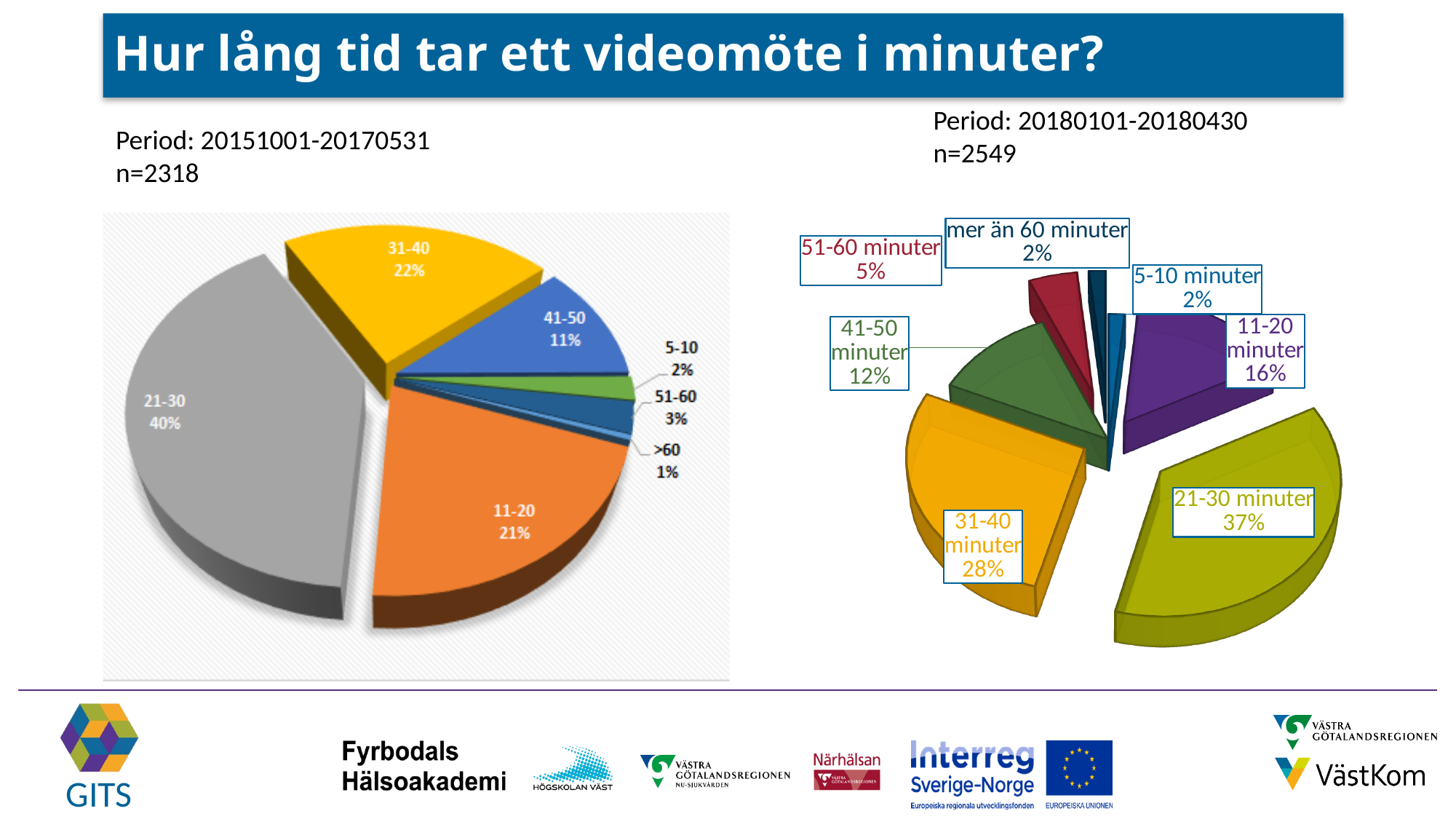
In the right pie chart (period 20180101-20180430), what share do meetings of 41-50 minuter have? 12% In the right pie chart (period 20180101-20180430), what share do meetings of 31-40 minutes have? 28% In the left pie chart (period 20151001-20170531), what share do meetings of 21-30 minutes have? 40% In the left pie chart (period 20151001-20170531), which duration category has the smallest share? >60 In the right pie chart (period 20180101-20180430), what is the difference in percentage points between the 21-30 minuter and 31-40 minuter slices? 9 What type of chart is shown on the left side of the slide? Pie chart In the left pie chart (period 20151001-20170531), which is larger: the 31-40 slice or the 11-20 slice? 31-40 How many slices does the right pie chart (period 20180101-20180430) have? 7 In the left pie chart (period 20151001-20170531), what is the difference in percentage points between the 41-50 slice and the 51-60 slice? 8 What is the sample size (n) stated for the right pie chart (period 20180101-20180430)? n=2549 In the left pie chart (period 20151001-20170531), which duration category has the largest share? 21-30 In the right pie chart (period 20180101-20180430), which duration category has the largest share? 21-30 minuter